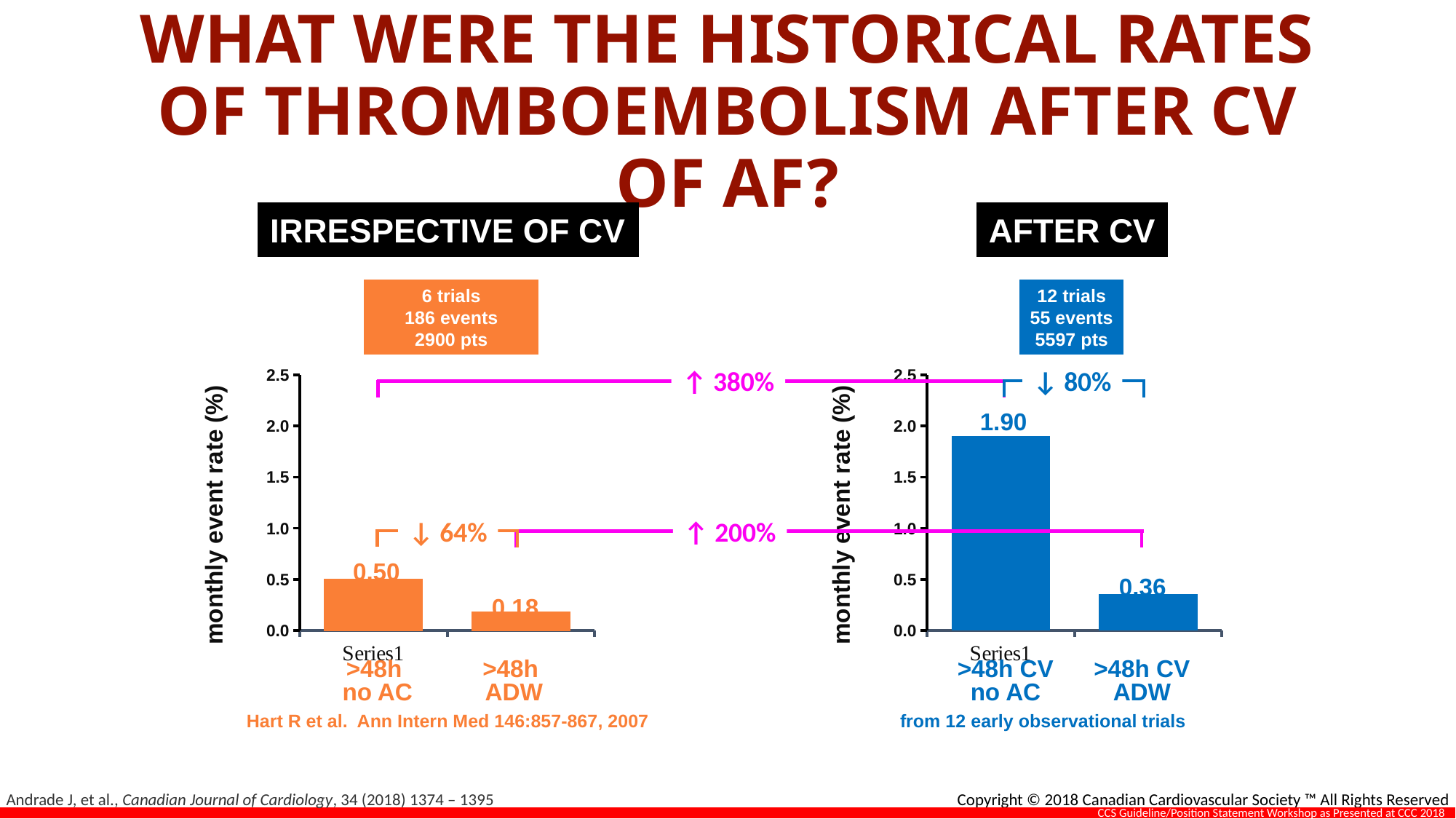
In the 'IRRESPECTIVE OF CV' chart, which category has the lowest monthly event rate? >48h ADW In the 'AFTER CV' chart, what is the monthly event rate for '>48h CV no AC'? 1.90 In the 'AFTER CV' chart, what is the difference in monthly event rate between '>48h CV no AC' and '>48h CV ADW'? 1.54 In the 'AFTER CV' chart, which category has the highest monthly event rate? >48h CV no AC In the 'IRRESPECTIVE OF CV' chart, what is the difference in monthly event rate between '>48h no AC' and '>48h ADW'? 0.32 Which is larger: the '>48h no AC' value in the 'IRRESPECTIVE OF CV' chart or the '>48h CV no AC' value in the 'AFTER CV' chart? >48h CV no AC In the 'IRRESPECTIVE OF CV' chart, what is the monthly event rate for '>48h ADW'? 0.18 In the 'AFTER CV' chart, what is the monthly event rate for '>48h CV ADW'? 0.36 What type of chart is the 'AFTER CV' chart? Bar chart In the 'AFTER CV' chart, is the value for '>48h CV no AC' greater or less than 1.5? greater How many bars are plotted in the 'IRRESPECTIVE OF CV' chart? 2 In the 'IRRESPECTIVE OF CV' chart, what is the monthly event rate for '>48h no AC'? 0.50